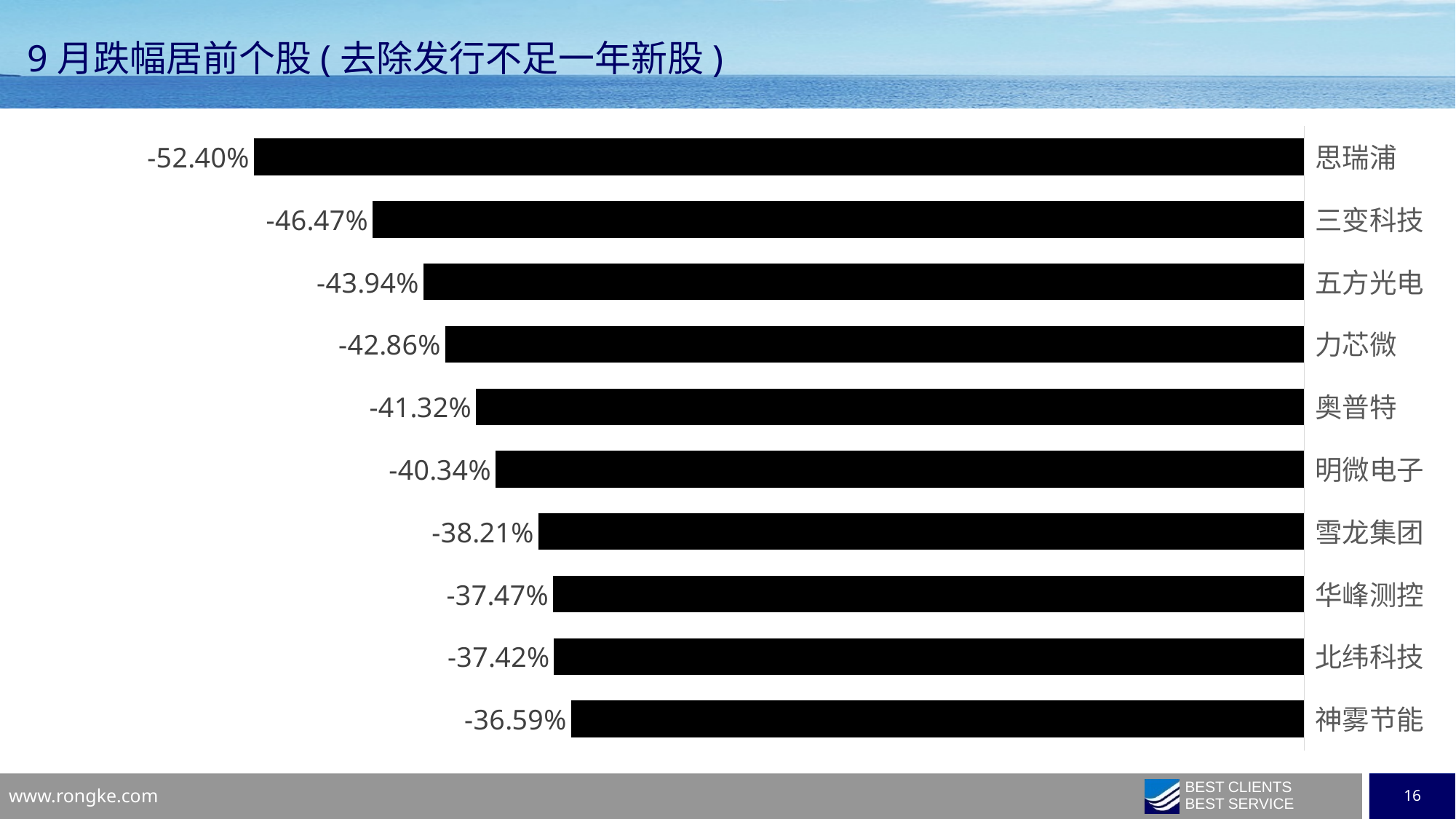
What is the value shown for 力芯微? -42.86% What is the difference in percentage points between the values for 三变科技 and 五方光电? 2.53 percentage points Which stock has the smallest decline (the highest value) on the chart? 神雾节能 What is the value shown for 神雾节能? -36.59% What is the difference in percentage points between the values for 思瑞浦 and 神雾节能? 15.81 percentage points Which stock fell more in September, 奥普特 or 雪龙集团? 奥普特 How many stocks are shown on the chart? 10 Which stock has the largest decline (the lowest value) on the chart? 思瑞浦 What is the value shown for 明微电子? -40.34% What kind of chart is shown on the slide? Bar chart What is the value shown for 思瑞浦? -52.40% What is the title of the slide? 9月跌幅居前个股（去除发行不足一年新股）